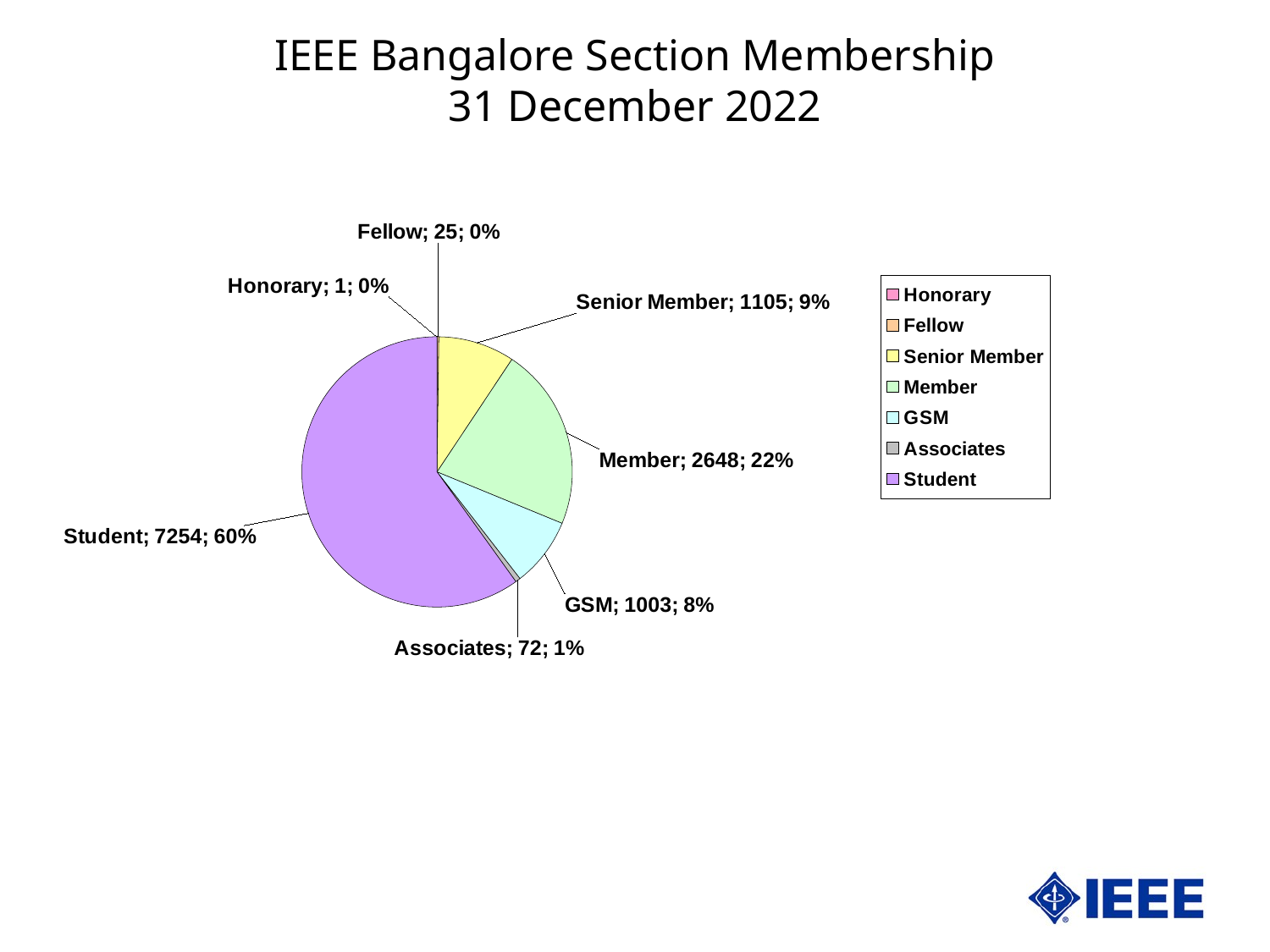
What is the value for GSM? 1003 How many members are in the Student category? 7254 What kind of chart is shown on the slide? pie chart How many categories does the pie chart have? 7 What share of the pie does the Member category represent? 22% What is the difference between the Member and Senior Member values? 1543 What is the title of the chart? IEEE Bangalore Section Membership 31 December 2022 Which category has the smallest slice of the pie? Honorary What is the value for Senior Member? 1105 What share of the pie does the Student category represent? 60% Which is larger, the value for Fellow or the value for Associates? Associates Which category has the largest slice of the pie? Student